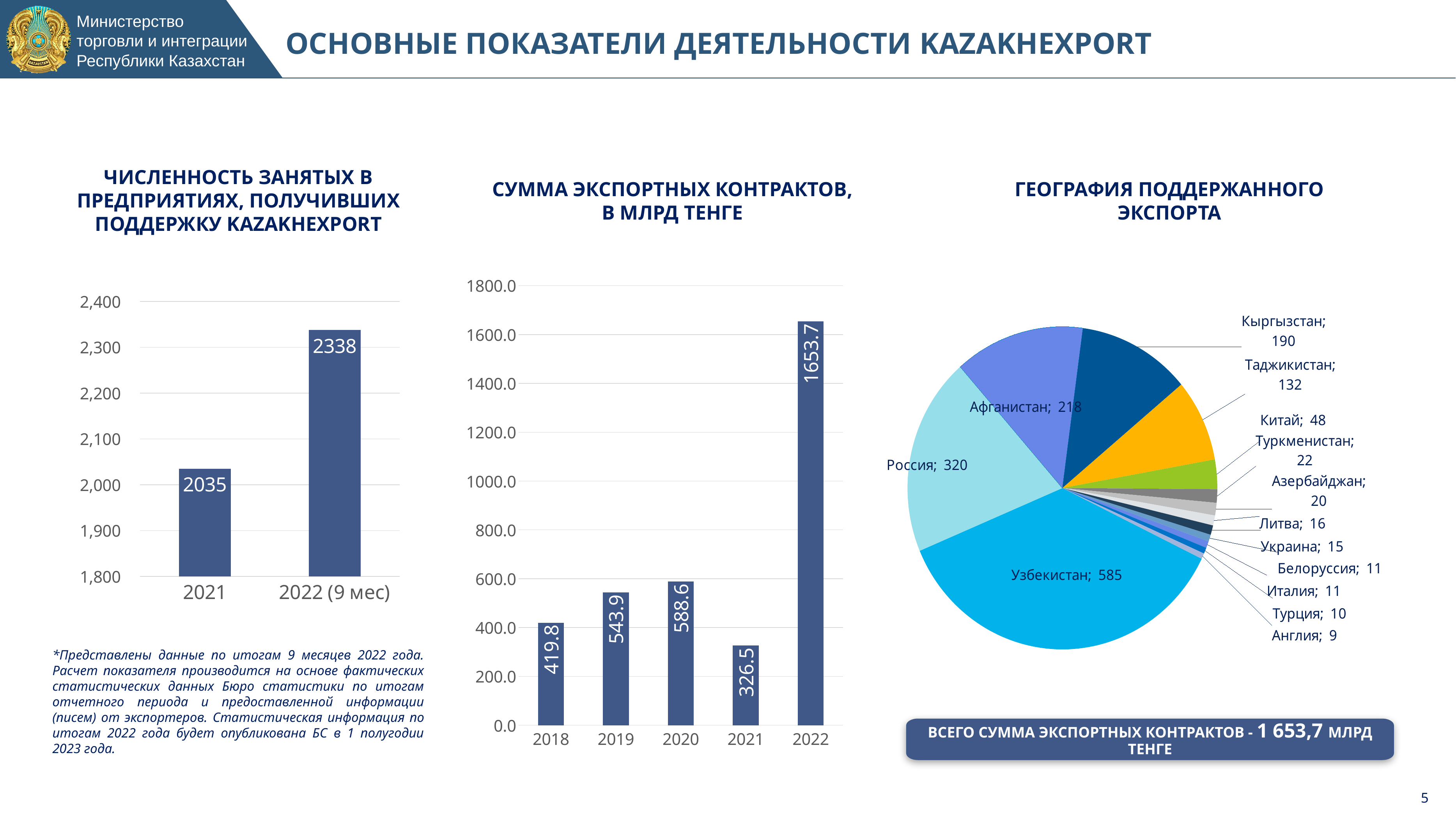
In the chart 'ГЕОГРАФИЯ ПОДДЕРЖАННОГО ЭКСПОРТА', how many countries are shown? 14 In the chart 'ГЕОГРАФИЯ ПОДДЕРЖАННОГО ЭКСПОРТА', what is the value for Россия? 320 In the chart 'СУММА ЭКСПОРТНЫХ КОНТРАКТОВ, В МЛРД ТЕНГЕ', how many years are shown on the x axis? 5 In the chart 'СУММА ЭКСПОРТНЫХ КОНТРАКТОВ, В МЛРД ТЕНГЕ', which year has the lowest value? 2021 In the chart 'СУММА ЭКСПОРТНЫХ КОНТРАКТОВ, В МЛРД ТЕНГЕ', what is the difference between the 2022 value and the 2021 value? 1327.2 In the chart 'СУММА ЭКСПОРТНЫХ КОНТРАКТОВ, В МЛРД ТЕНГЕ', which year has the highest value? 2022 In the chart 'ЧИСЛЕННОСТЬ ЗАНЯТЫХ В ПРЕДПРИЯТИЯХ, ПОЛУЧИВШИХ ПОДДЕРЖКУ KAZAKHEXPORT', what is the difference between the 2022 (9 мес) value and the 2021 value? 303 In the chart 'ГЕОГРАФИЯ ПОДДЕРЖАННОГО ЭКСПОРТА', which country has the largest slice? Узбекистан In the chart 'ЧИСЛЕННОСТЬ ЗАНЯТЫХ В ПРЕДПРИЯТИЯХ, ПОЛУЧИВШИХ ПОДДЕРЖКУ KAZAKHEXPORT', what is the value for 2021? 2035 In the chart 'ГЕОГРАФИЯ ПОДДЕРЖАННОГО ЭКСПОРТА', which is larger, Кыргызстан or Таджикистан? Кыргызстан What kind of chart is 'ГЕОГРАФИЯ ПОДДЕРЖАННОГО ЭКСПОРТА'? Pie chart In the chart 'СУММА ЭКСПОРТНЫХ КОНТРАКТОВ, В МЛРД ТЕНГЕ', what is the value for 2020? 588.6